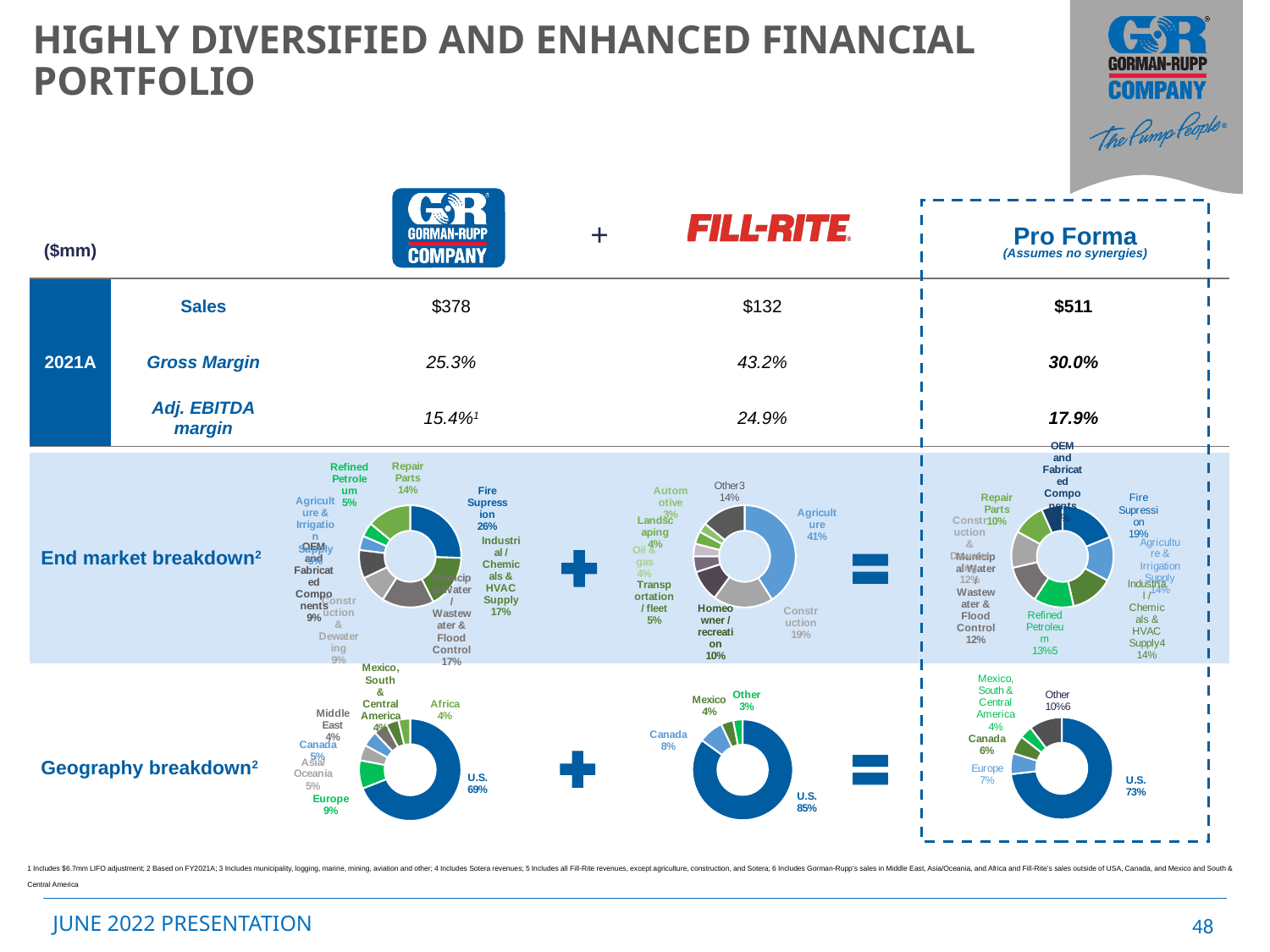
In the Fill-Rite geography breakdown chart, what is the difference between the U.S. share and the Canada share? 77% In the Pro Forma geography breakdown chart, what share is the U.S.? 73% What type of chart is used for the geography breakdown of Gorman-Rupp? Pie (donut) chart In the Fill-Rite end market breakdown chart, what share is Agriculture? 41% In the Fill-Rite end market breakdown chart, which is larger: Construction or Homeowner / recreation? Construction In the Gorman-Rupp geography breakdown chart, what share is the U.S.? 69% In the Fill-Rite end market breakdown chart, which end market has the largest share? Agriculture In the Pro Forma end market breakdown chart, what share is Fire Suppression? 19% In the Fill-Rite geography breakdown chart, how many regions are shown? 4 In the Fill-Rite geography breakdown chart, what share is the U.S.? 85% In the Fill-Rite geography breakdown chart, which region has the smallest share? Other In the Gorman-Rupp end market breakdown chart, what share is Fire Suppression? 26%